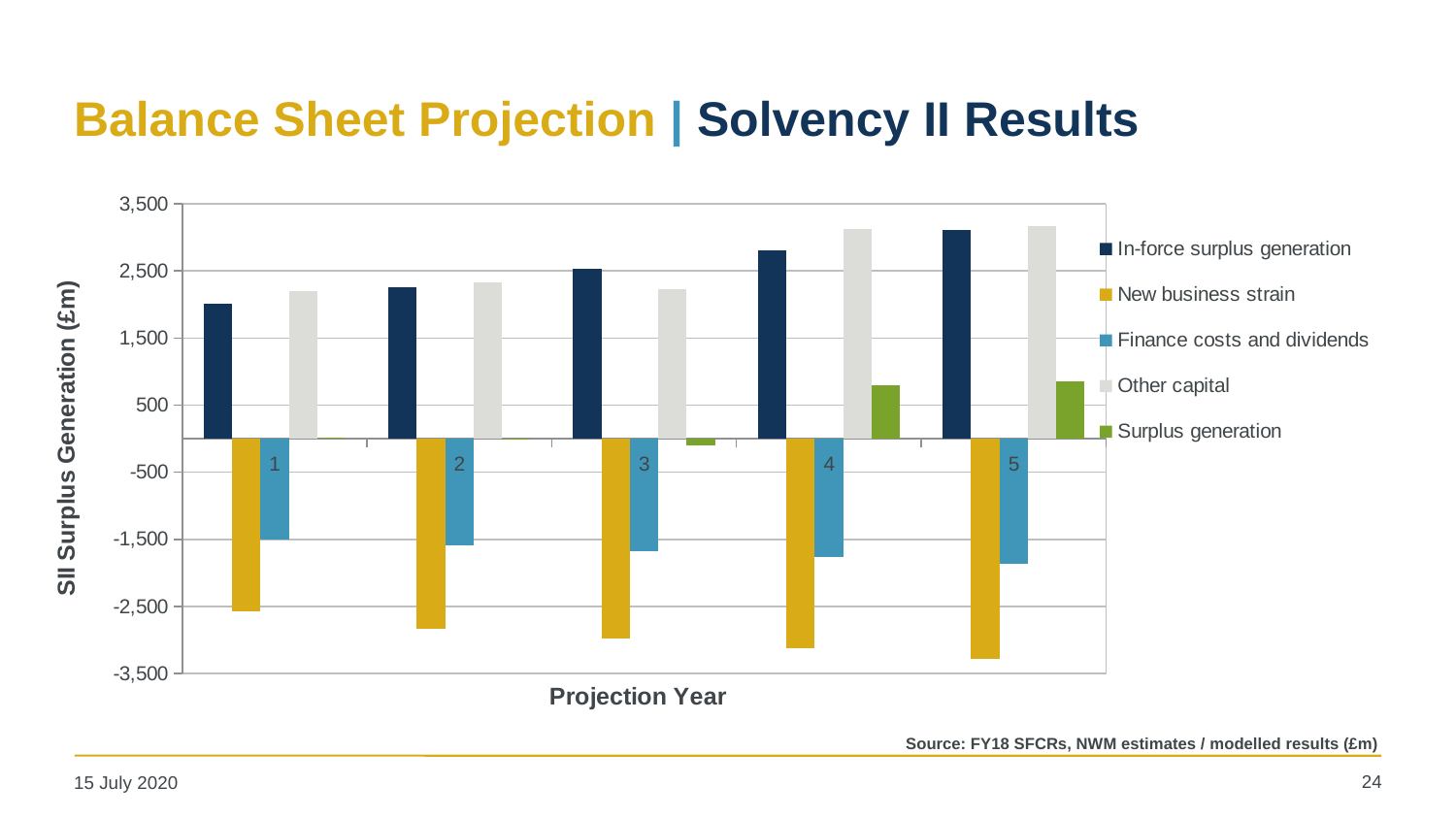
Is the In-force surplus generation value for projection year 5 greater or less than 2,500? greater Is the Other capital value for projection year 4 greater or less than 2,500? greater Which projection year has the highest In-force surplus generation? 5 Is the Surplus generation value for projection year 4 greater or less than 500? greater Which projection year has the lowest In-force surplus generation? 1 What is the title of the vertical axis? SII Surplus Generation (£m) How many series does the legend list? 5 What kind of chart is shown on the slide? Bar chart Does In-force surplus generation rise or fall from projection year 1 to projection year 5? Rise In projection year 1, which is larger: In-force surplus generation or Other capital? Other capital How many projection years are shown on the x axis? 5